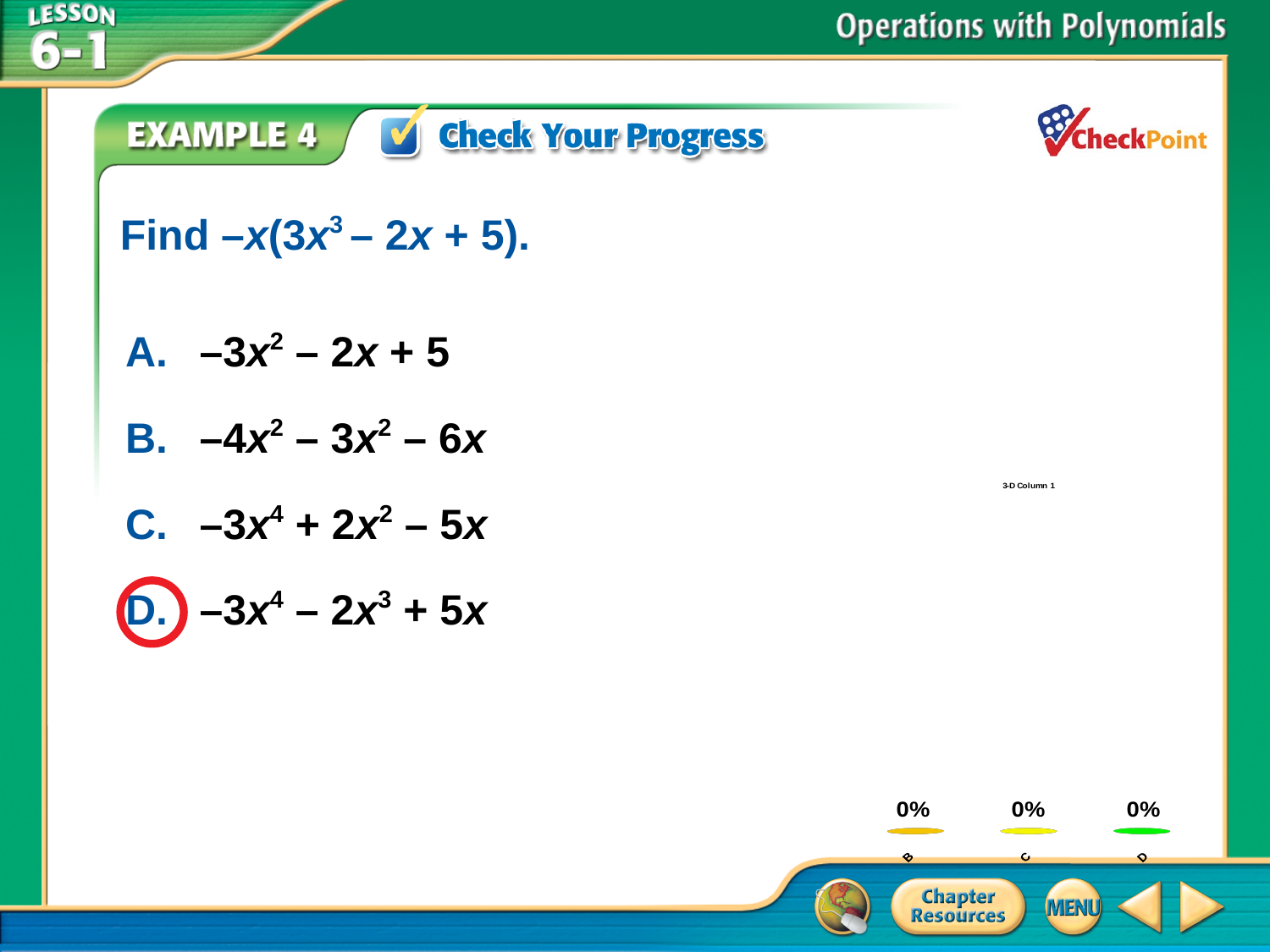
How many categories are plotted in the chart? 3 What kind of chart is shown on the slide? bar chart What is the value shown for category C in the chart? 0% What colour is the bar for category D in the chart? green What is the value shown for category B in the chart? 0% What is the difference between the values for B and C in the chart? 0% What is the value shown for category D in the chart? 0% Do the values rise, fall, or stay the same across categories B, C and D? stay the same